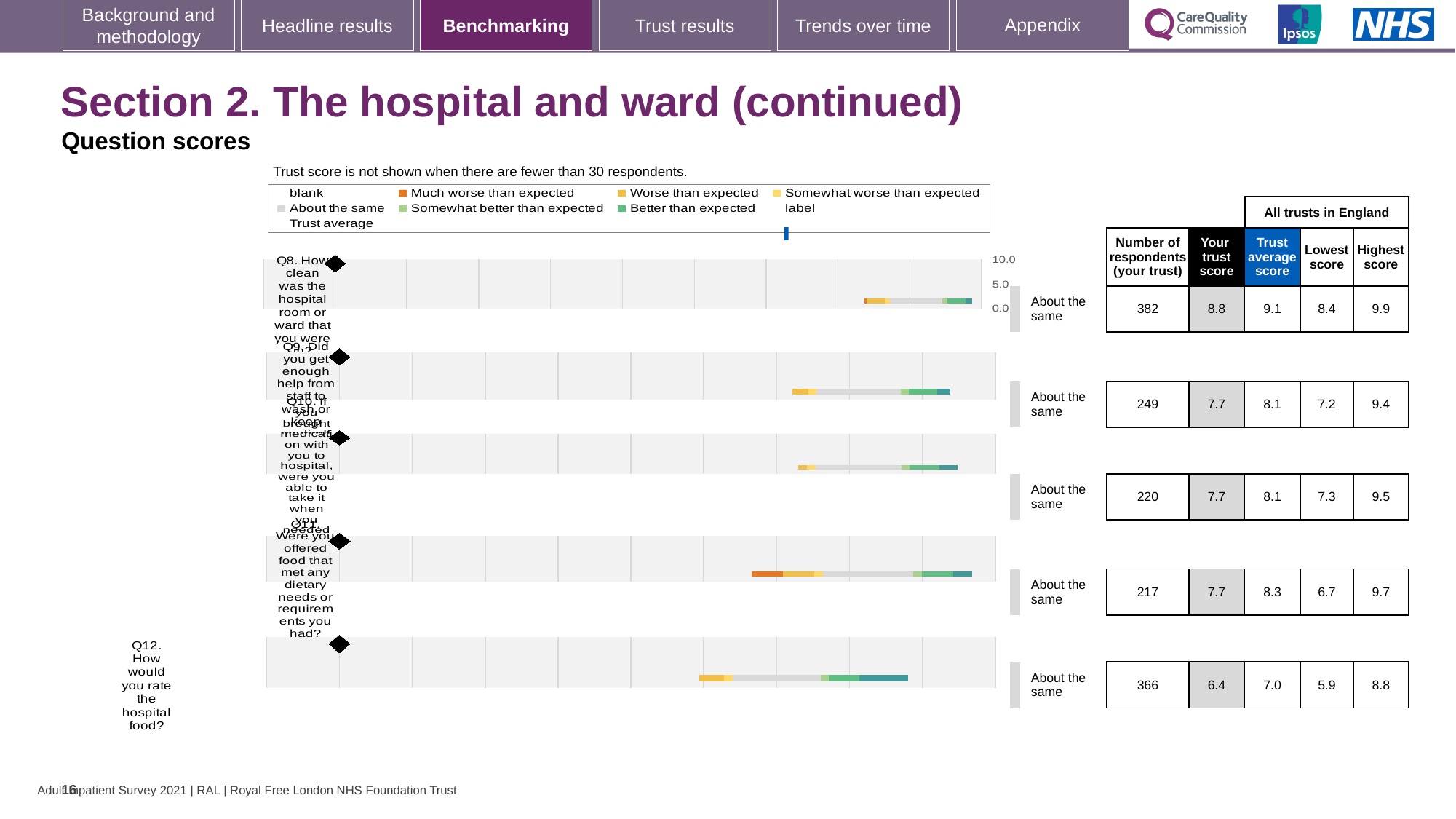
What is the benchmark category shown for Q10 (bringing medication with you to hospital)? About the same Which question has the lowest 'Your trust score'? Q12 What is the number of respondents for Q12 (how would you rate the hospital food)? 366 What is the 'Your trust score' for Q8 (how clean was the hospital room or ward)? 8.8 What is the lowest score across all trusts in England for Q11? 6.7 Which question has the highest 'Your trust score'? Q8 What kind of chart is used to show the question scores on this slide? bar chart Is the 'Your trust score' for Q9 larger or smaller than the trust average score for Q9? smaller What is the trust average score for Q11 (offered food that met dietary needs)? 8.3 How many questions (Q8 to Q12) are plotted in the chart? 5 What is the difference between the highest score and the lowest score for Q12? 2.9 What colour in the legend represents 'Much worse than expected'? orange